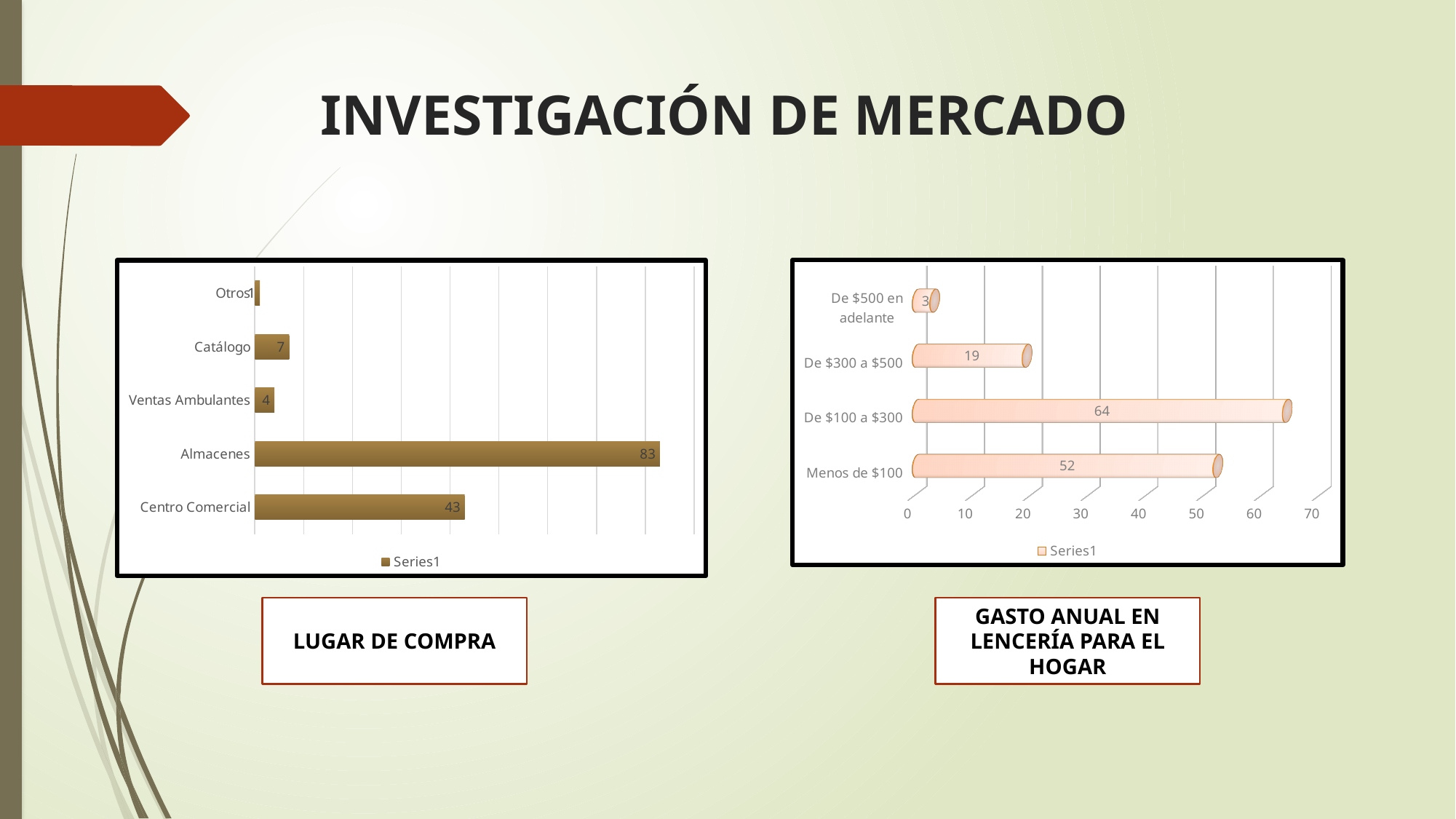
In the GASTO ANUAL EN LENCERÍA PARA EL HOGAR chart, what is the value for Menos de $100? 52 In the LUGAR DE COMPRA chart, which category has the lowest value? Otros In the LUGAR DE COMPRA chart, what is the value for Centro Comercial? 43 In the LUGAR DE COMPRA chart, what is the difference between Almacenes and Centro Comercial? 40 What kind of chart is the GASTO ANUAL EN LENCERÍA PARA EL HOGAR chart? Bar chart In the GASTO ANUAL EN LENCERÍA PARA EL HOGAR chart, what is the value for De $100 a $300? 64 In the LUGAR DE COMPRA chart, which category has the highest value? Almacenes In the LUGAR DE COMPRA chart, what is the value for Almacenes? 83 In the GASTO ANUAL EN LENCERÍA PARA EL HOGAR chart, which category has the lowest value? De $500 en adelante In the GASTO ANUAL EN LENCERÍA PARA EL HOGAR chart, what is the difference between De $100 a $300 and De $300 a $500? 45 In the GASTO ANUAL EN LENCERÍA PARA EL HOGAR chart, which is larger: De $300 a $500 or Menos de $100? Menos de $100 In the LUGAR DE COMPRA chart, how many categories are shown? 5